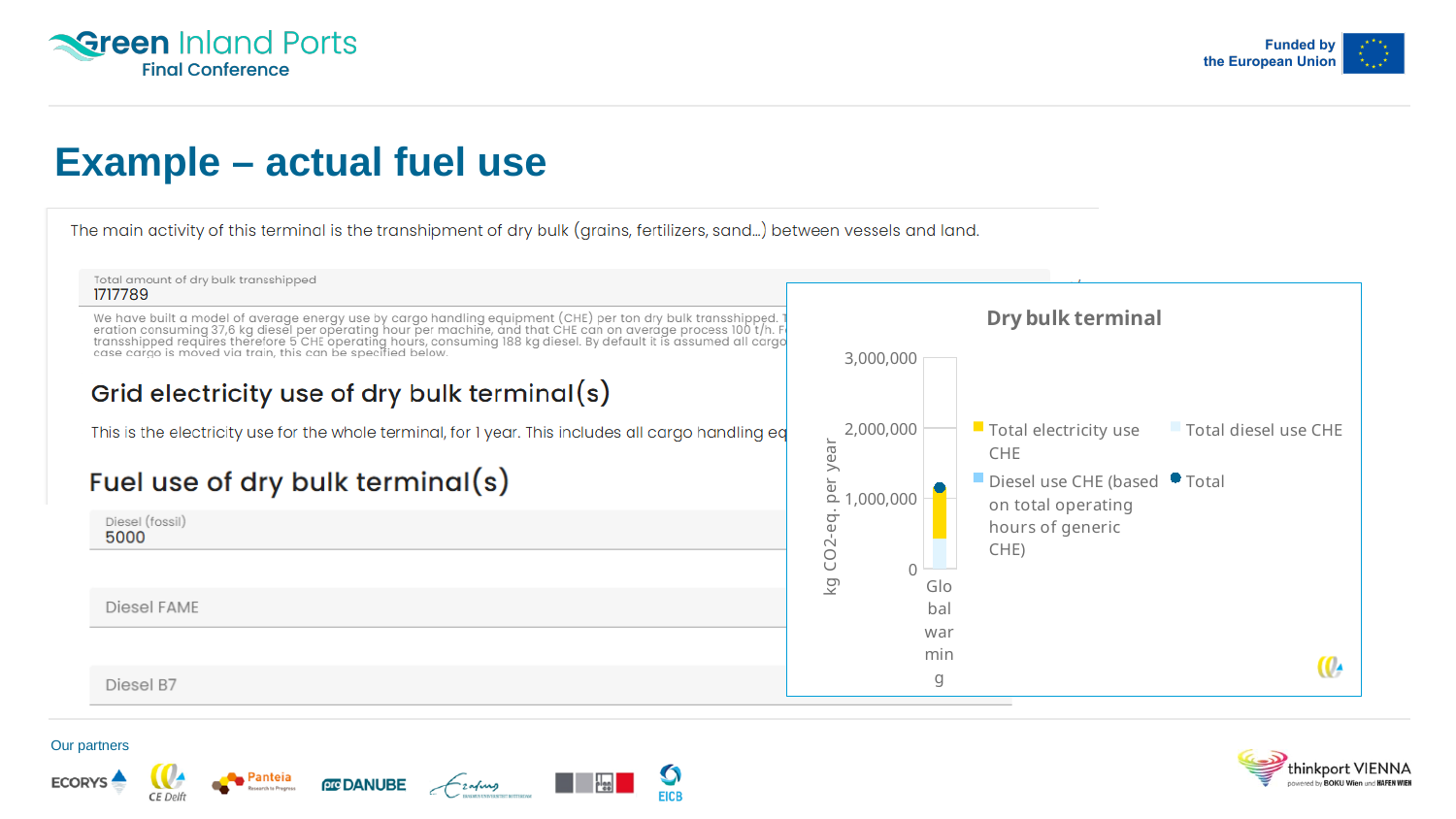
What is the title of the chart on the right side of the slide? Dry bulk terminal In the "Dry bulk terminal" chart, is the Total diesel use CHE value for Global warming greater or less than 1,000,000? less How many categories are plotted on the x axis of the "Dry bulk terminal" chart? 1 How many series does the legend of the "Dry bulk terminal" chart list? 4 What is the label of the single category on the x axis of the "Dry bulk terminal" chart? Global warming In the "Dry bulk terminal" chart, is the Total value for Global warming greater or less than 3,000,000? less In the "Dry bulk terminal" chart, is the Total value for Global warming greater or less than 2,000,000? less What kind of chart is shown under the title "Dry bulk terminal"? bar chart In the "Dry bulk terminal" chart, which is larger for Global warming: Total electricity use CHE or Total diesel use CHE? Total electricity use CHE